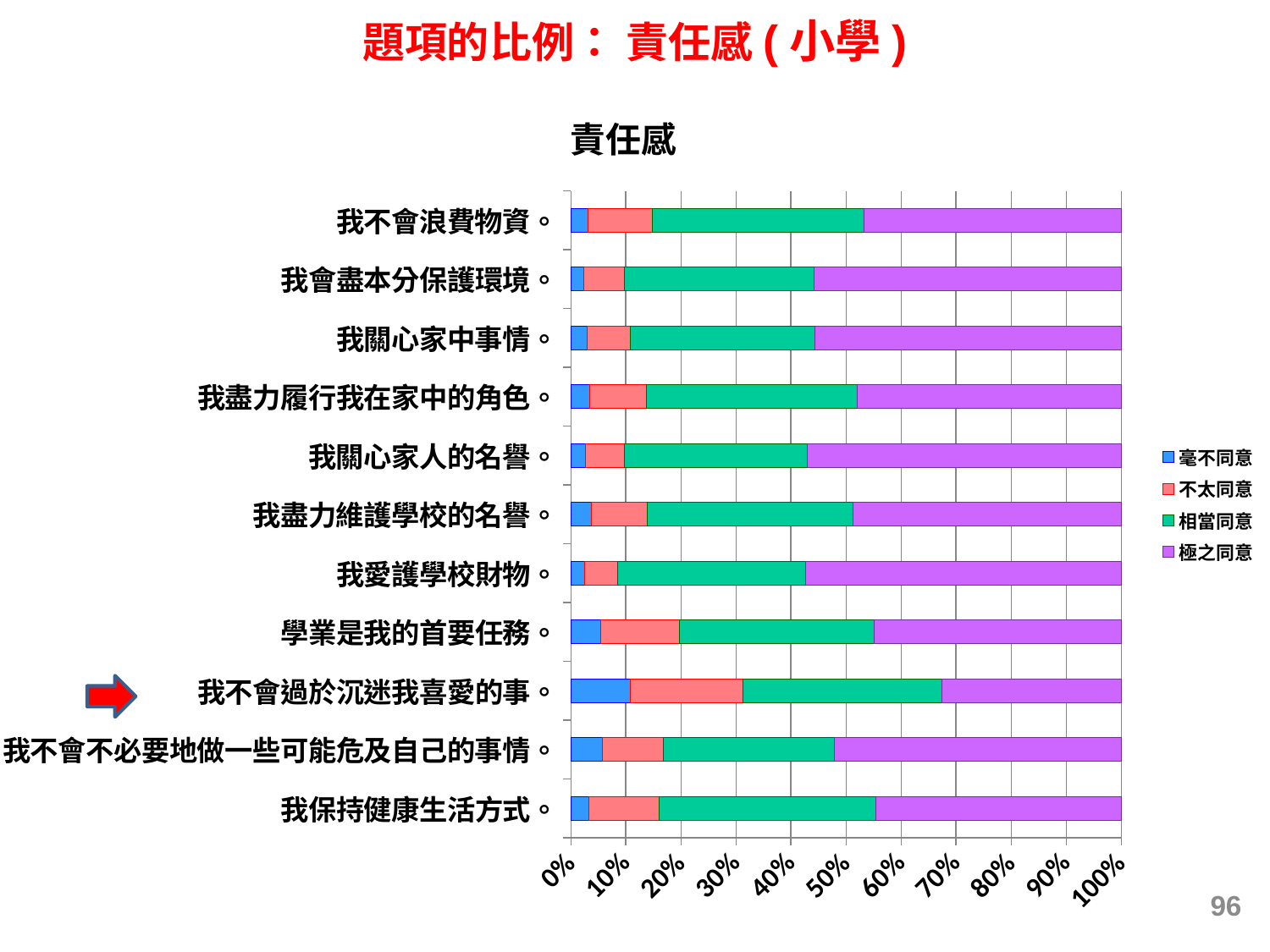
Which statement has the smallest 極之同意 share? 我不會過於沉迷我喜愛的事。 Which legend entry is shown in purple? 極之同意 What does each stacked bar total on the x axis? 100% Is the 極之同意 share for 我不會過於沉迷我喜愛的事 greater or less than 40%? less Which statement has the largest 毫不同意 share? 我不會過於沉迷我喜愛的事。 Which statement has a larger 極之同意 share, 我關心家中事情 or 我不會過於沉迷我喜愛的事? 我關心家中事情。 How many series does the legend list? 4 Which statement has the largest 不太同意 share? 我不會過於沉迷我喜愛的事。 What is the title of the chart? 責任感 What kind of chart is shown on the slide? Stacked bar chart Is the 極之同意 share for 我關心家中事情 greater or less than 50%? greater How many statement categories are plotted on the chart? 11